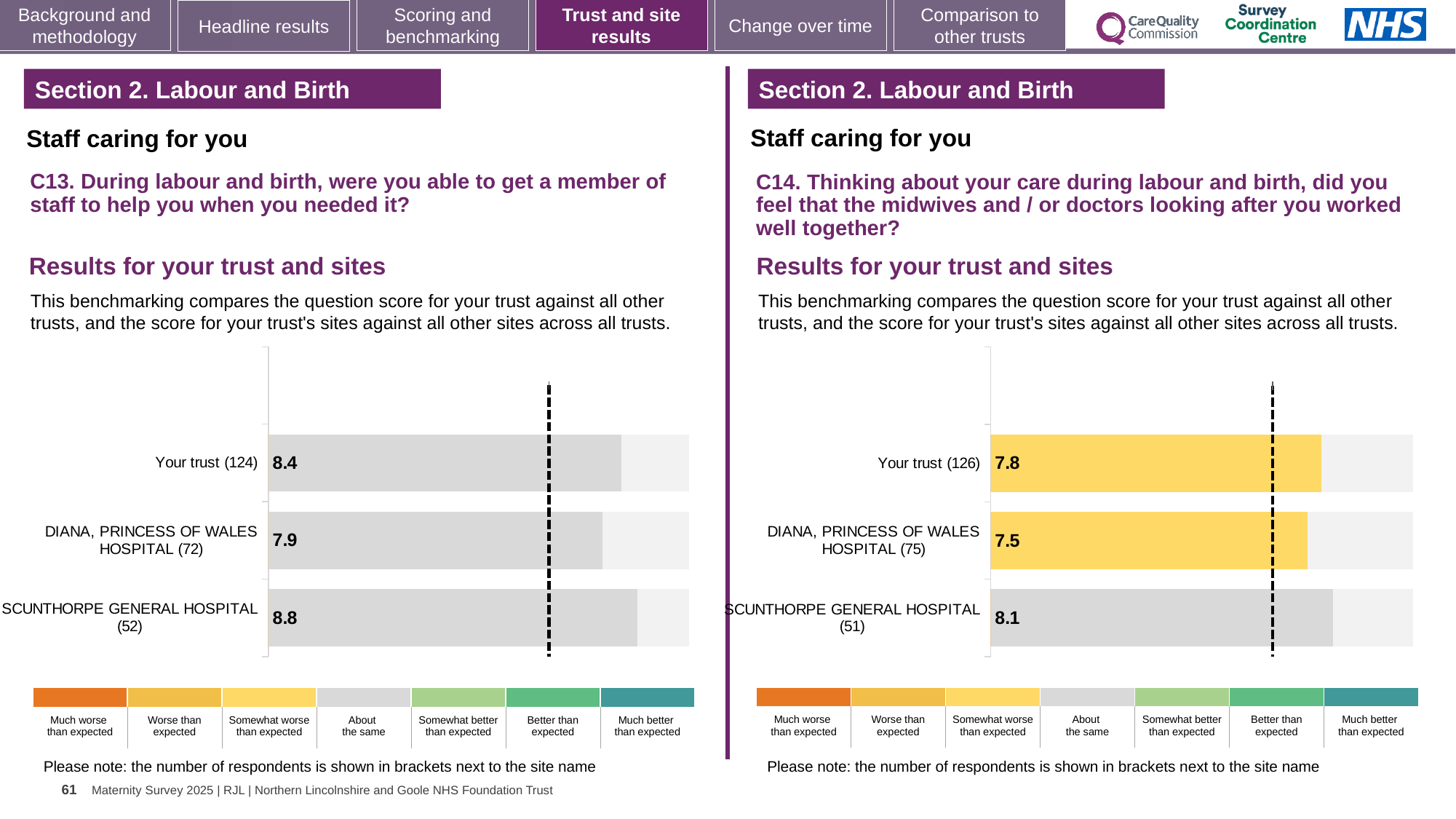
What type of chart is used in the C14 chart on the right? Bar chart How many bars are plotted in the C13 chart on the left? 3 In the C14 chart on the right, which site or trust has the lowest score? Diana, Princess of Wales Hospital In the C13 chart on the left, what is the score for Scunthorpe General Hospital? 8.8 In the C13 chart on the left, what is the difference between the scores for Scunthorpe General Hospital and Diana, Princess of Wales Hospital? 0.9 In the C14 chart on the right, what is the score for Your trust? 7.8 In the C14 chart on the right, which has the higher score: Your trust or Scunthorpe General Hospital? Scunthorpe General Hospital In the C14 chart on the right, what is the score for Diana, Princess of Wales Hospital? 7.5 In the C13 chart on the left, how many respondents are shown in brackets for Diana, Princess of Wales Hospital? 72 In the C13 chart on the left, what is the score for Your trust? 8.4 In the C14 chart on the right, what is the difference between the scores for Scunthorpe General Hospital and Your trust? 0.3 In the C13 chart on the left, which site or trust has the highest score? Scunthorpe General Hospital